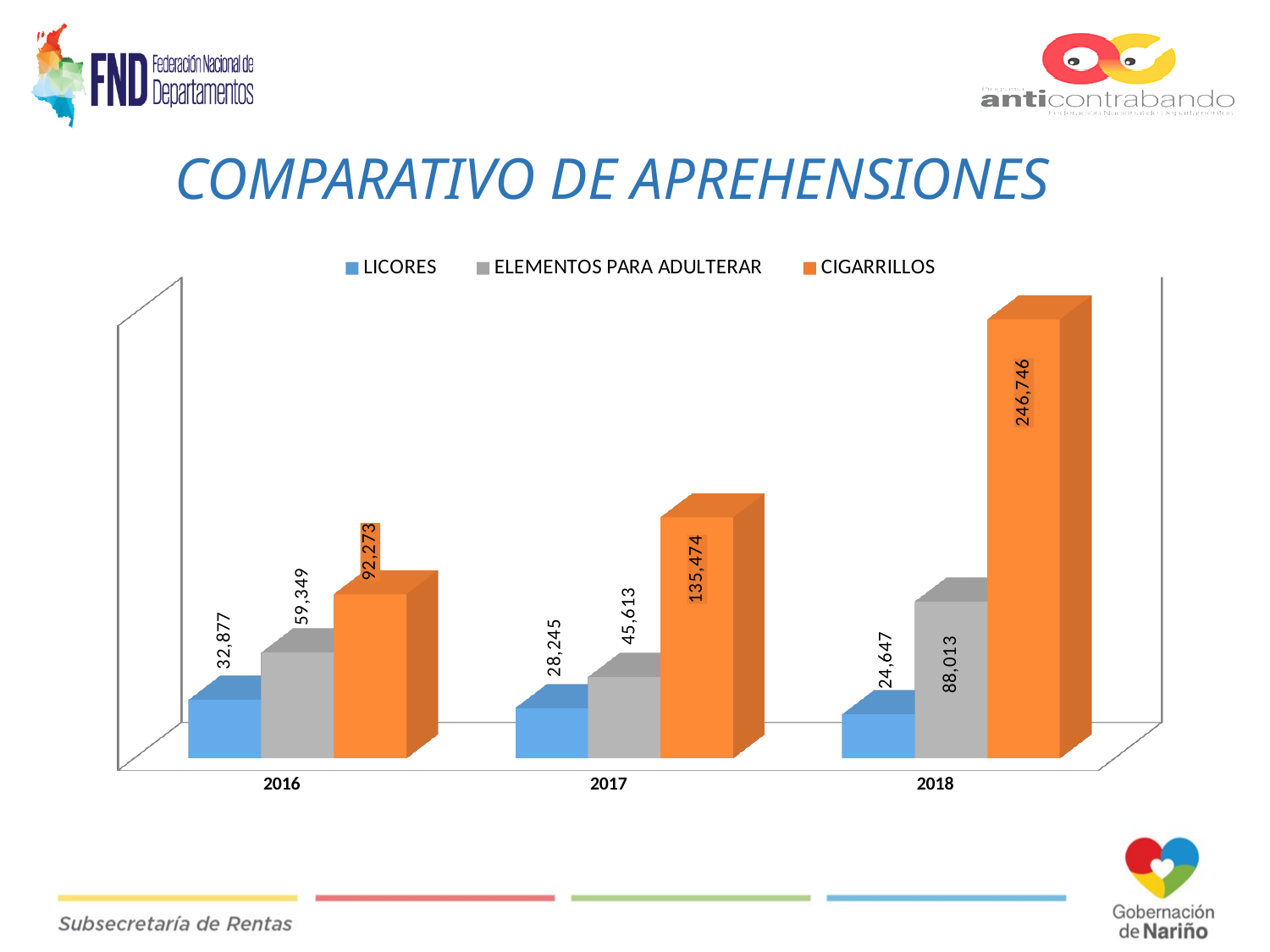
How many years are shown on the x axis? 3 What is the difference between the CIGARRILLOS values for 2018 and 2017? 111,272 What is the difference between the ELEMENTOS PARA ADULTERAR values for 2018 and 2017? 42,400 In which year is the LICORES value lowest? 2018 What is the value for CIGARRILLOS in 2018? 246,746 What is the value for ELEMENTOS PARA ADULTERAR in 2017? 45,613 Do the LICORES values rise or fall from 2016 to 2018? Fall What kind of chart is shown on the slide? Bar chart What is the value for LICORES in 2016? 32,877 How many series does the legend list? 3 In which year is the CIGARRILLOS value highest? 2018 Which is larger: ELEMENTOS PARA ADULTERAR in 2016 or ELEMENTOS PARA ADULTERAR in 2017? ELEMENTOS PARA ADULTERAR in 2016